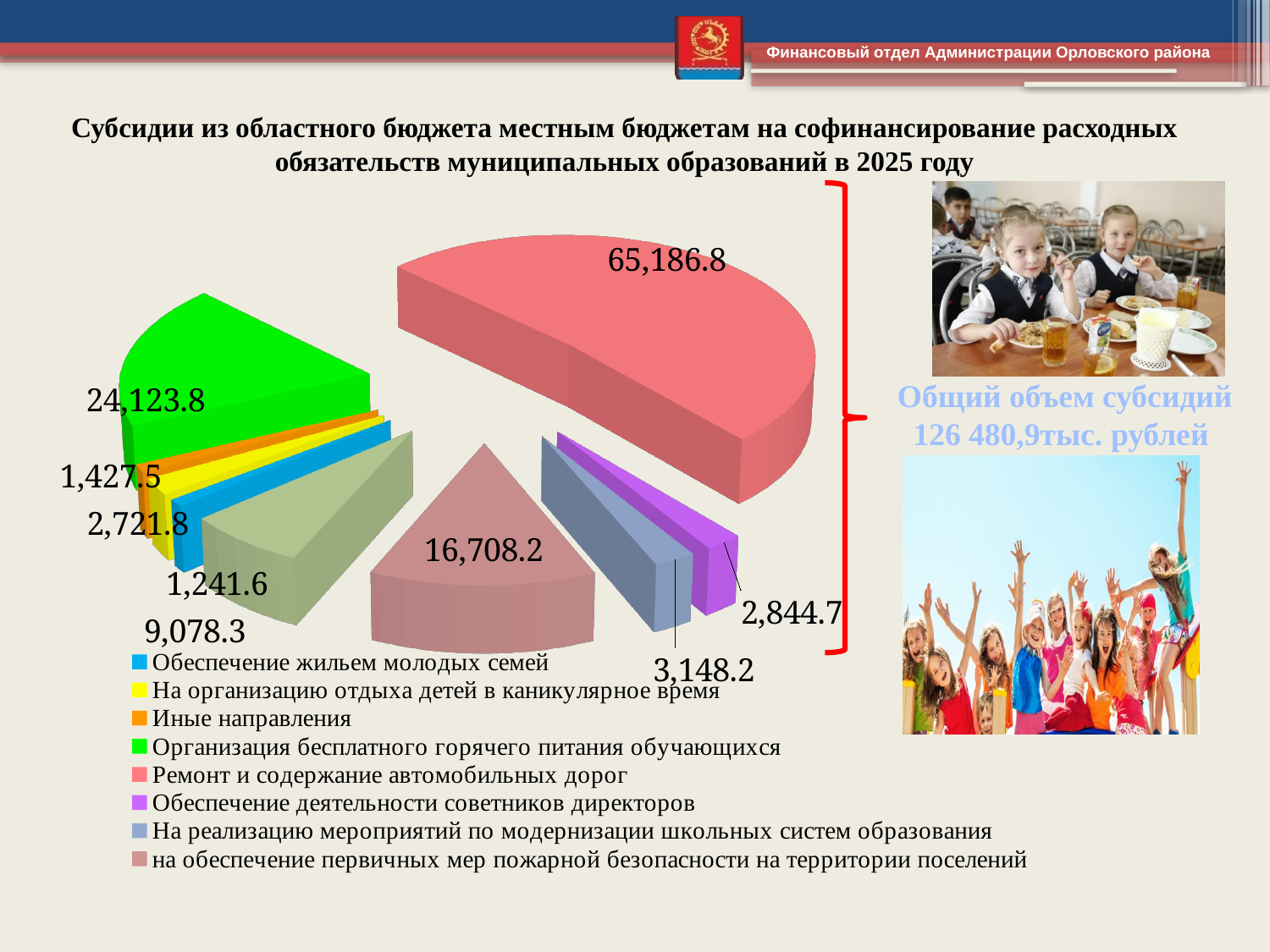
What is the value for "Обеспечение деятельности советников директоров"? 2,844.7 What is the value for "Ремонт и содержание автомобильных дорог"? 65,186.8 How many entries does the legend list? 8 Which category has the largest slice of the pie? Ремонт и содержание автомобильных дорог What is the value for "На реализацию мероприятий по модернизации школьных систем образования"? 3,148.2 What kind of chart is shown on the slide? pie chart What is the value for "на обеспечение первичных мер пожарной безопасности на территории поселений"? 16,708.2 Which is larger: the value for "Организация бесплатного горячего питания обучающихся" or for "на обеспечение первичных мер пожарной безопасности на территории поселений"? Организация бесплатного горячего питания обучающихся What total volume of subsidies is stated next to the chart? 126 480,9 тыс. рублей What is the difference between the values for "Ремонт и содержание автомобильных дорог" and "Организация бесплатного горячего питания обучающихся"? 41,063.0 What is the value for "Организация бесплатного горячего питания обучающихся"? 24,123.8 What is the smallest value labelled on the pie chart? 1,241.6